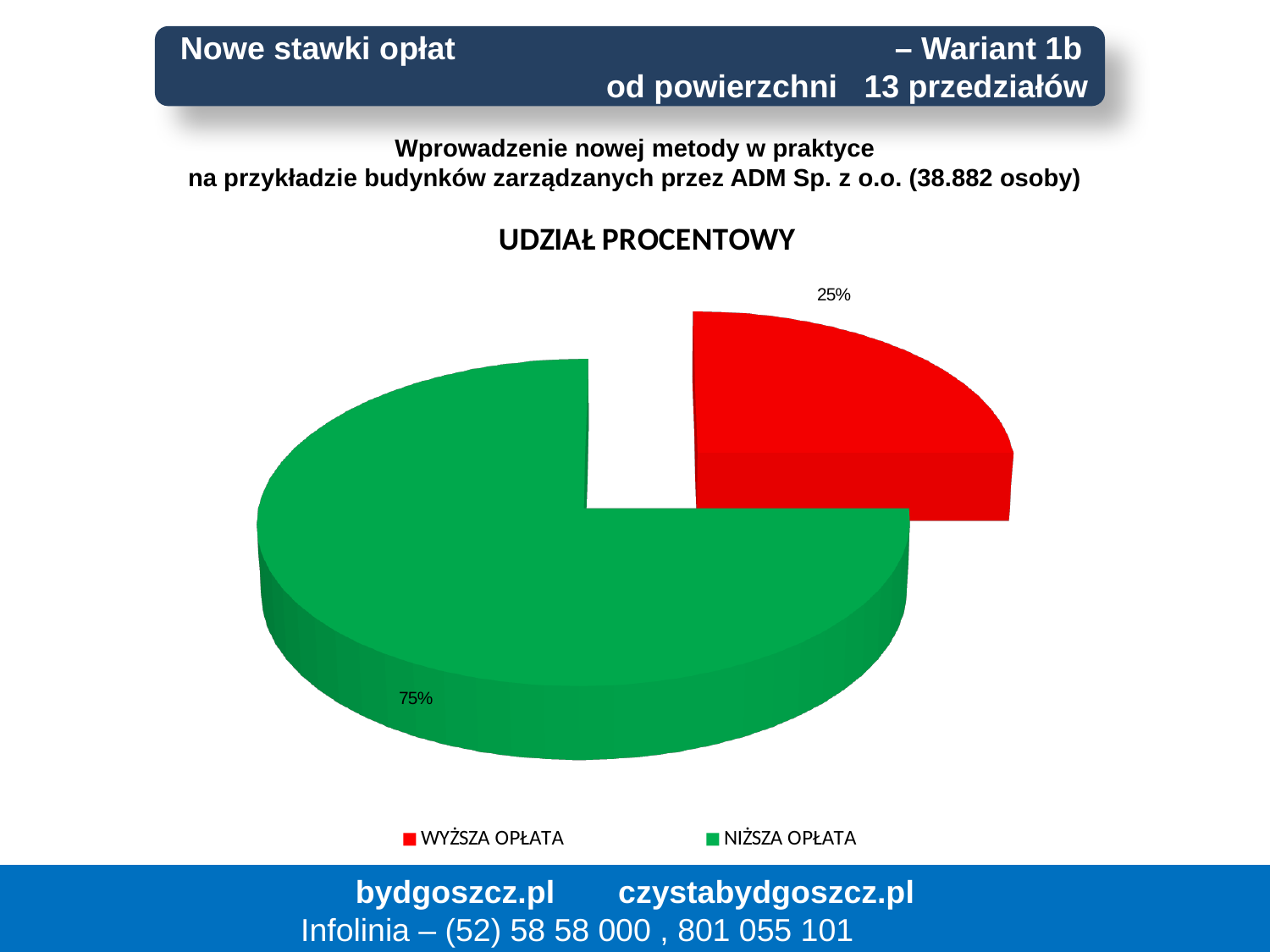
What share of the pie does NIŻSZA OPŁATA represent? 75% How many entries does the legend list? 2 Which category has the largest slice of the pie? NIŻSZA OPŁATA What share of the pie does WYŻSZA OPŁATA represent? 25% Which category has the smallest slice of the pie? WYŻSZA OPŁATA What type of chart is shown on the slide? Pie chart What is the title of the chart? UDZIAŁ PROCENTOWY What is the difference in percentage points between the NIŻSZA OPŁATA and WYŻSZA OPŁATA slices? 50 Which slice is larger, WYŻSZA OPŁATA or NIŻSZA OPŁATA? NIŻSZA OPŁATA How many slices does the pie chart have? 2 What colour is the WYŻSZA OPŁATA slice? Red